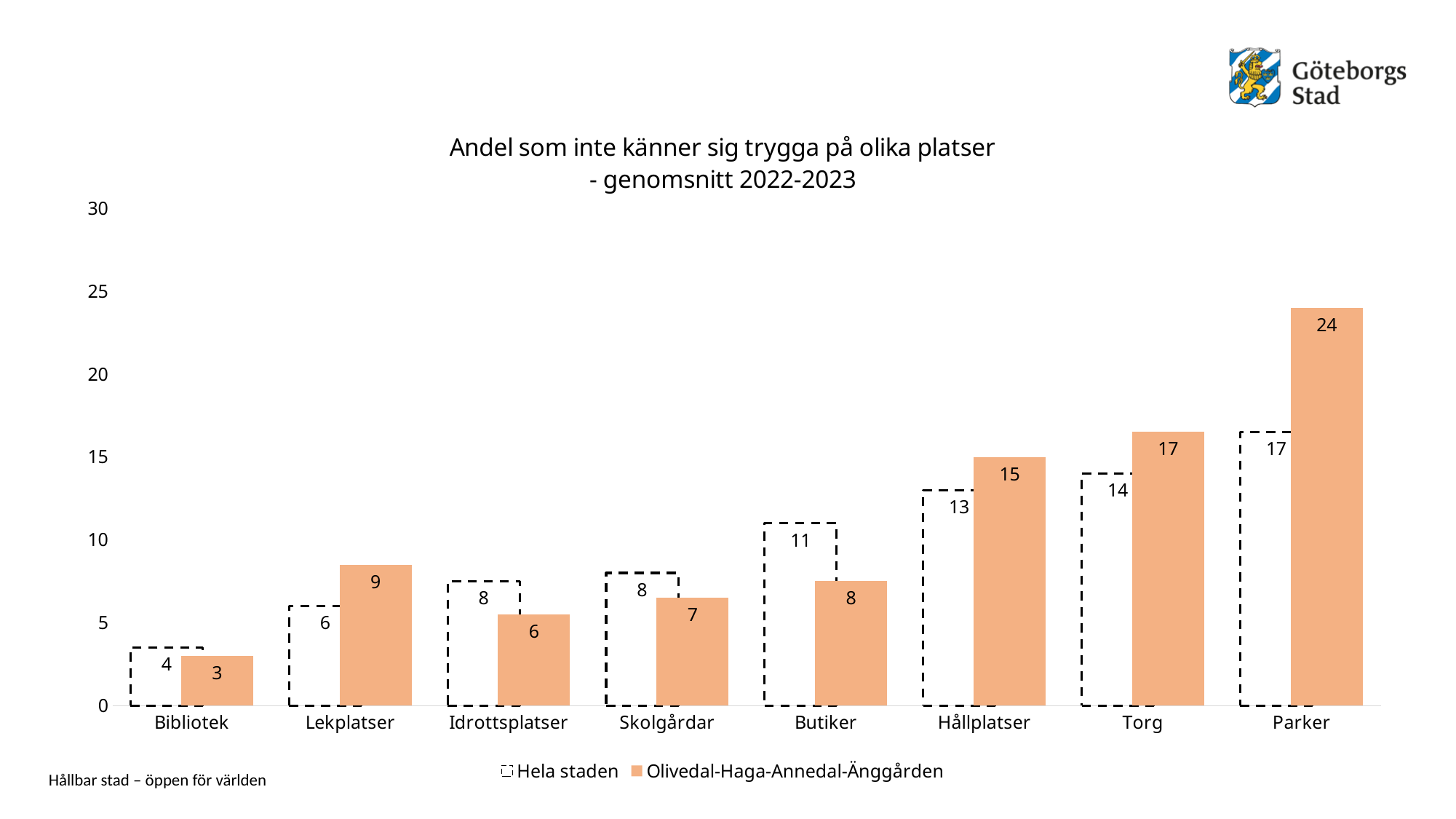
What kind of chart is shown on the slide? Bar chart What is the value for Olivedal-Haga-Annedal-Änggården at Parker? 24 What is the value for Olivedal-Haga-Annedal-Änggården at Bibliotek? 3 How many categories are shown on the x axis? 8 Which category has the highest value for Olivedal-Haga-Annedal-Änggården? Parker What is the title of the chart? Andel som inte känner sig trygga på olika platser - genomsnitt 2022-2023 Which category has the lowest value for Hela staden? Bibliotek How many series does the legend list? 2 Is the value for Olivedal-Haga-Annedal-Änggården at Hållplatser greater or less than 10? greater What is the difference between the Olivedal-Haga-Annedal-Änggården value and the Hela staden value at Parker? 7 What is the value for Hela staden at Butiker? 11 At Butiker, which series has the larger value, Hela staden or Olivedal-Haga-Annedal-Änggården? Hela staden